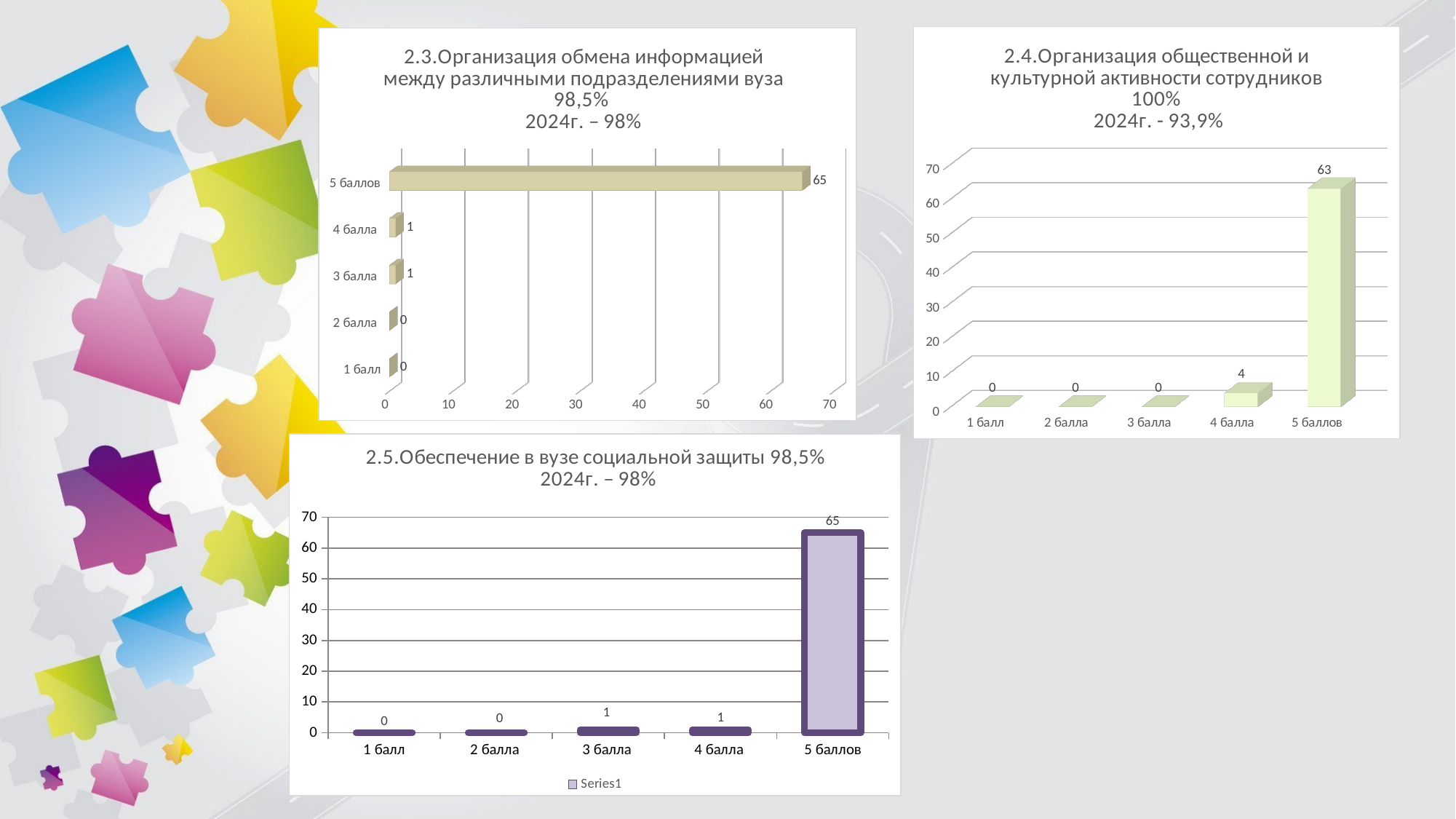
In the chart titled "2.3.Организация обмена информацией между различными подразделениями вуза", what kind of chart is shown? Bar chart In the chart titled "2.3.Организация обмена информацией между различными подразделениями вуза", what is the value for 4 балла? 1 In the chart titled "2.4.Организация общественной и культурной активности сотрудников", which category has the highest value? 5 баллов In the chart titled "2.4.Организация общественной и культурной активности сотрудников", what is the difference between the values for 5 баллов and 4 балла? 59 In the chart titled "2.5.Обеспечение в вузе социальной защиты", what is the value for 5 баллов? 65 In the chart titled "2.3.Организация обмена информацией между различными подразделениями вуза", how many categories are plotted? 5 In the chart titled "2.5.Обеспечение в вузе социальной защиты", what is the value for 3 балла? 1 In the chart titled "2.3.Организация обмена информацией между различными подразделениями вуза", what is the value for 5 баллов? 65 In the chart titled "2.5.Обеспечение в вузе социальной защиты", which is larger, the value for 4 балла or the value for 5 баллов? 5 баллов In the chart titled "2.5.Обеспечение в вузе социальной защиты", how many series does the legend list? 1 In the chart titled "2.4.Организация общественной и культурной активности сотрудников", what is the value for 4 балла? 4 In the chart titled "2.4.Организация общественной и культурной активности сотрудников", what is the value for 5 баллов? 63